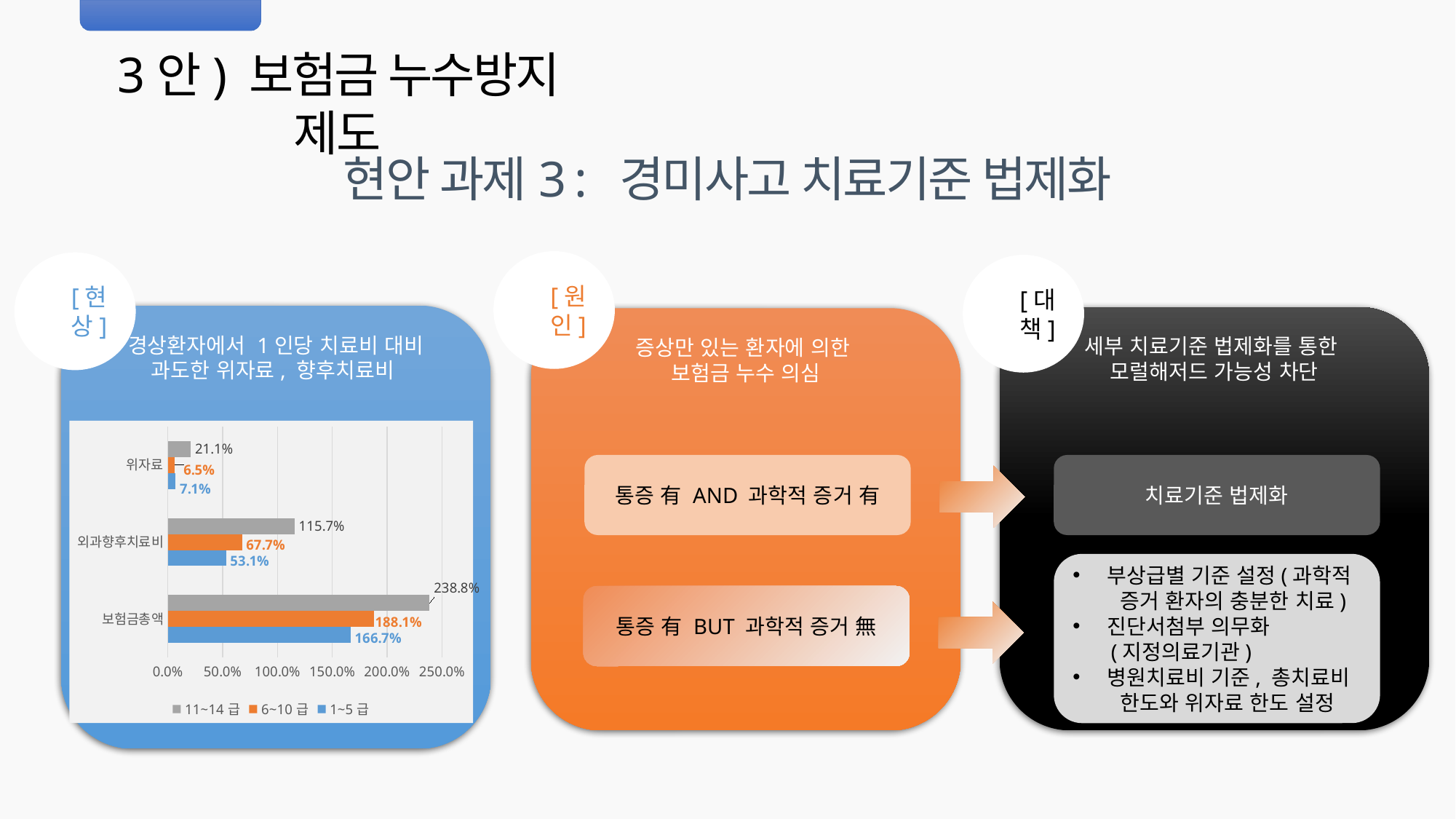
Which series is shown in gray in the chart legend? 11~14급 What is the difference between the 11~14급 and 6~10급 values in the 외과향후치료비 category? 48.0% Is the value for 11~14급 in the 외과향후치료비 category greater or less than 100.0%? greater What kind of chart is shown on the slide? bar chart What is the value for 6~10급 in the 위자료 category? 6.5% Which category has the lowest value for the 6~10급 series? 위자료 How many categories are shown on the chart's vertical axis? 3 How many series does the chart legend list? 3 What is the value for 1~5급 in the 외과향후치료비 category? 53.1% In the 보험금총액 category, which is larger: the 6~10급 value or the 1~5급 value? 6~10급 Which category has the highest value for the 11~14급 series? 보험금총액 What is the value for 11~14급 in the 보험금총액 category? 238.8%